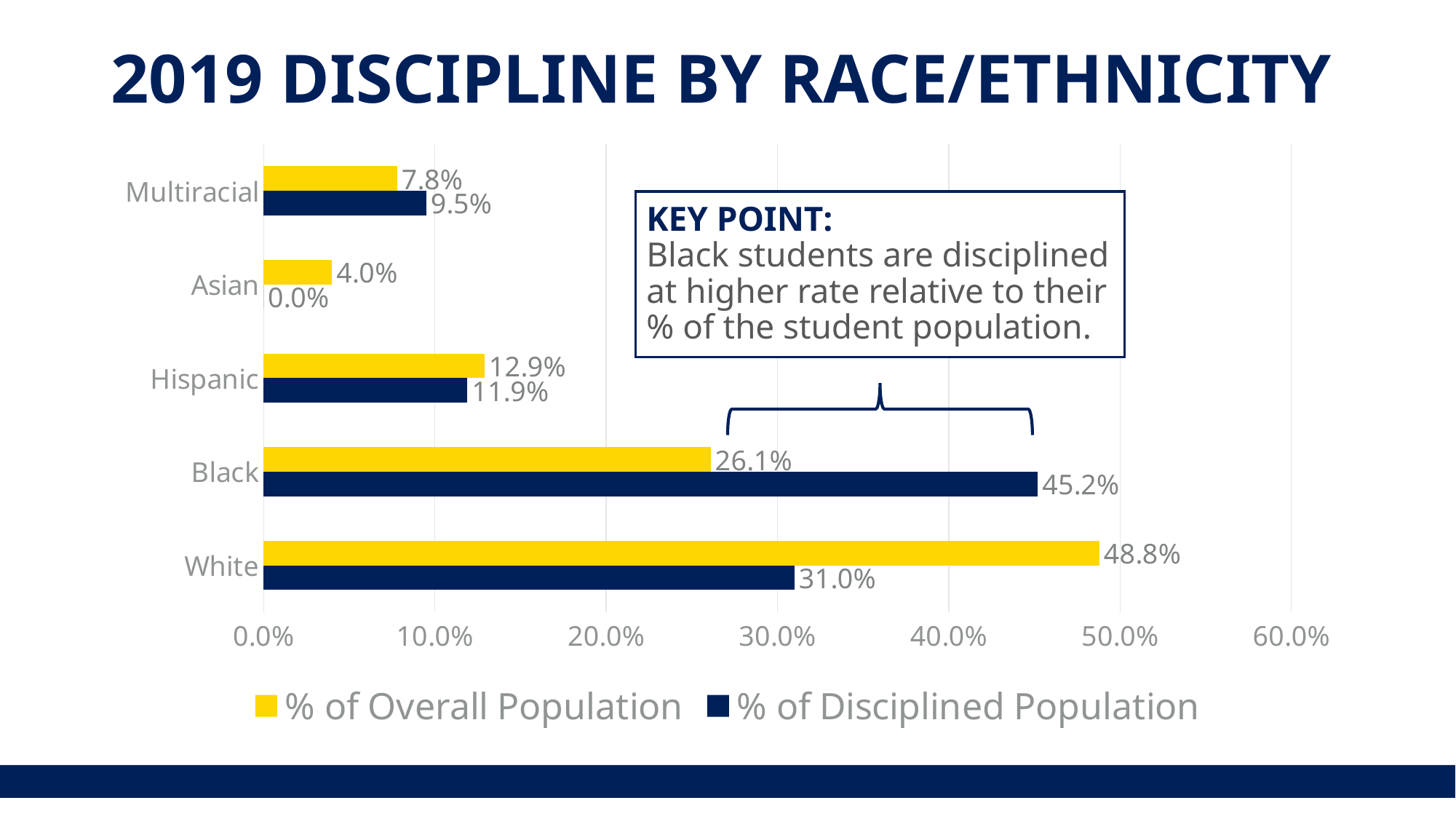
Which colour represents the % of Disciplined Population series? Dark blue How many series does the legend list? 2 What kind of chart is shown on the slide? Bar chart What is the % of Disciplined Population for Black students? 45.2% Which is larger for White students: the % of Overall Population or the % of Disciplined Population? % of Overall Population Which category has the highest % of Disciplined Population? Black What is the % of Overall Population for White students? 48.8% How many race/ethnicity categories are shown on the chart? 5 What is the % of Disciplined Population for Asian students? 0.0% What is the difference between the % of Disciplined Population and the % of Overall Population for Black students? 19.1% Which category has the lowest % of Overall Population? Asian What is the % of Overall Population for Hispanic students? 12.9%